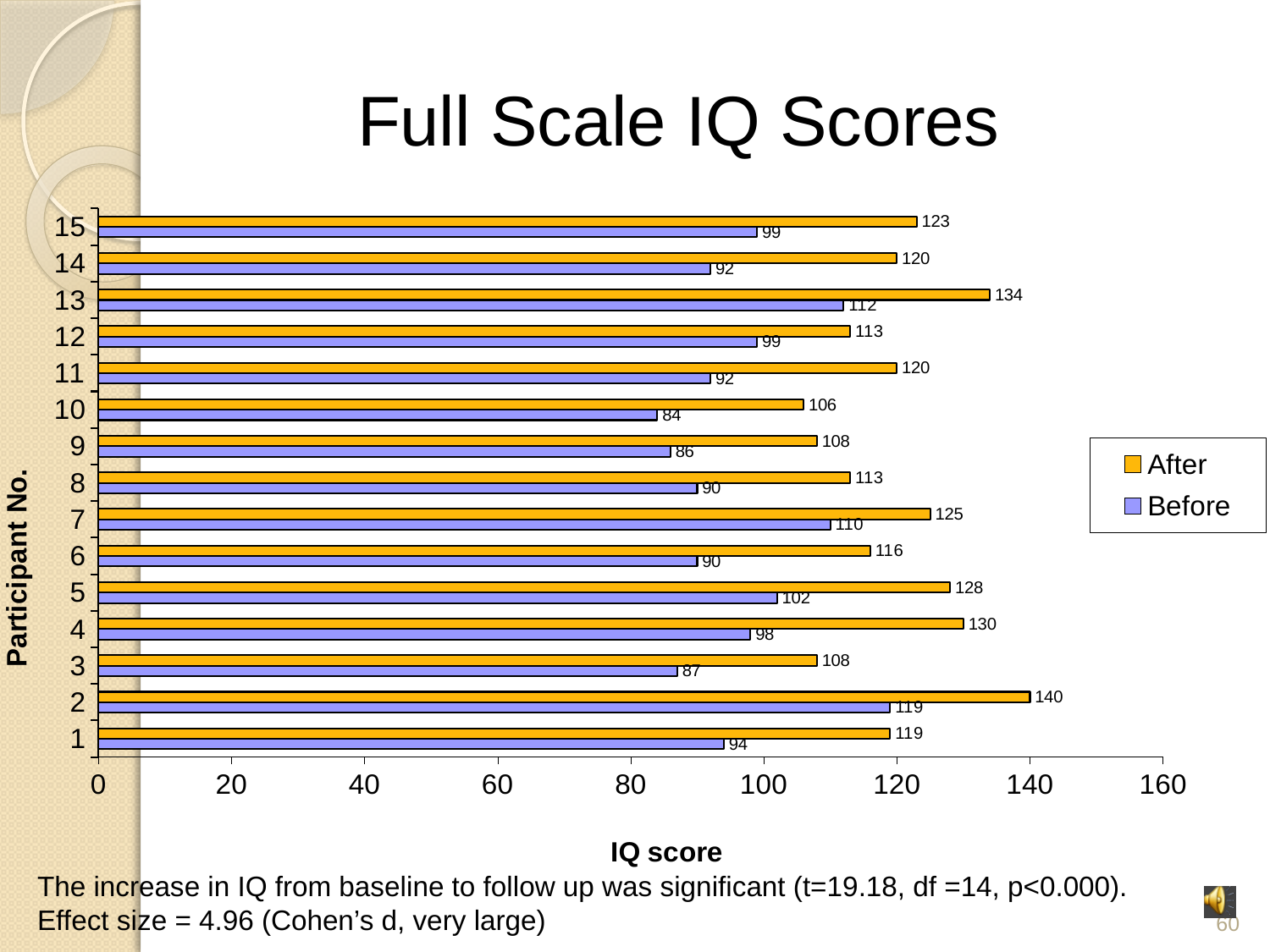
What is the title of the chart? Full Scale IQ Scores What is the Before IQ score for participant 7? 110 What kind of chart is shown on the slide? Bar chart Which is larger: the After score for participant 5 or the After score for participant 12? Participant 5 How many series does the legend list? 2 Which participant has the highest After IQ score? 2 Is the Before IQ score for participant 2 greater or less than 100? greater Which participant has the lowest Before IQ score? 10 What is the difference between the After and Before IQ scores for participant 4? 32 How many participants are shown on the chart? 15 Which colour represents the After series in the legend? Orange What is the After IQ score for participant 13? 134